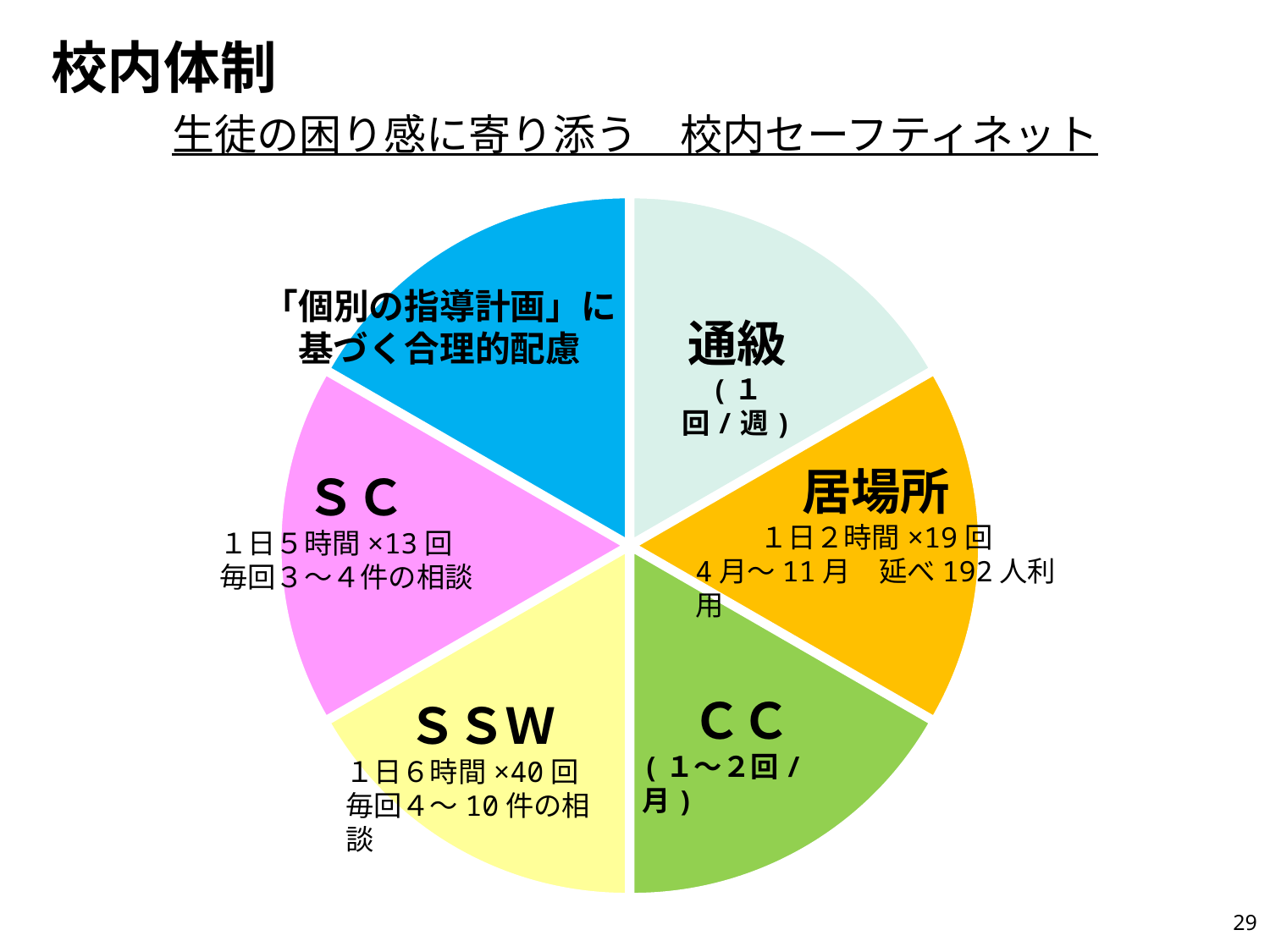
What is the title written above the pie chart? 生徒の困り感に寄り添う 校内セーフティネット According to the label in the 居場所 slice, how many people in total used it from April to November? 延べ192人 According to the label in the SC slice, how many times was SC provided (1日5時間 × ?)? 13回 How many slices does the pie chart have? 6 According to the label in the 通級 slice, how often is 通級 held? 1回/週 What kind of chart is shown on the slide? pie chart According to the label in the 居場所 slice, how many hours per day is 居場所 open? 2時間 What colour is the 居場所 slice of the pie chart? orange According to the label in the SSW slice, how many times was SSW provided (1日6時間 × ?)? 40回 According to the label in the CC slice, how often is CC held? 1～2回/月